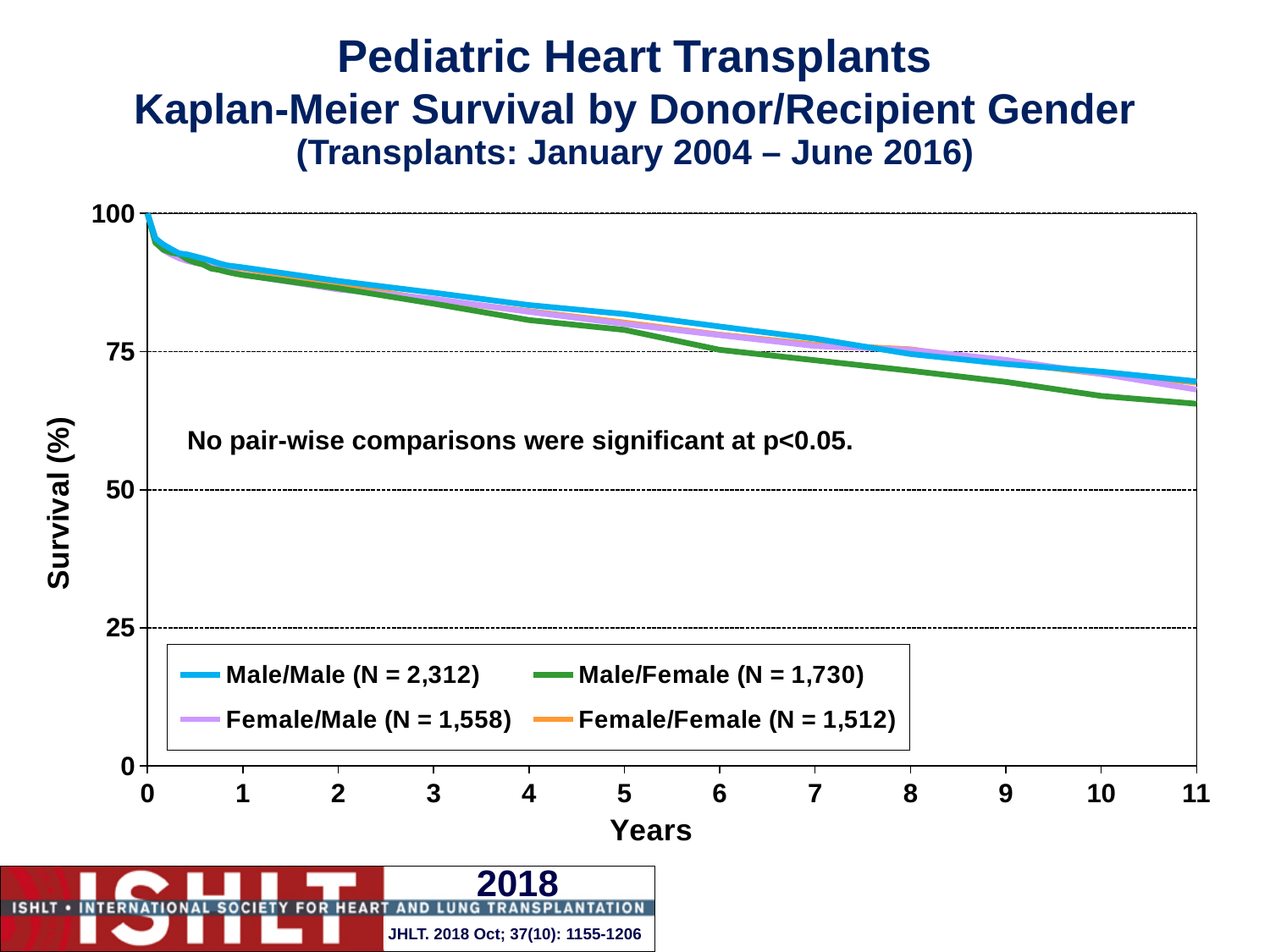
Do the survival curves rise or fall as years increase? fall Is the survival value for the Male/Male group at 3 years greater or less than 75? greater What is the N for the Female/Male group shown in the legend? 1,558 Which group has the lowest survival at 11 years? Male/Female What is the N for the Male/Female group shown in the legend? 1,730 What is the N for the Male/Male group shown in the legend? 2,312 What kind of chart is shown on the slide? line chart Which donor/recipient gender group has the largest N in the legend? Male/Male How many series does the legend list? 4 Is the survival value for the Male/Female group at 10 years greater or less than 75? less What is the N for the Female/Female group shown in the legend? 1,512 Which donor/recipient gender group has the smallest N in the legend? Female/Female